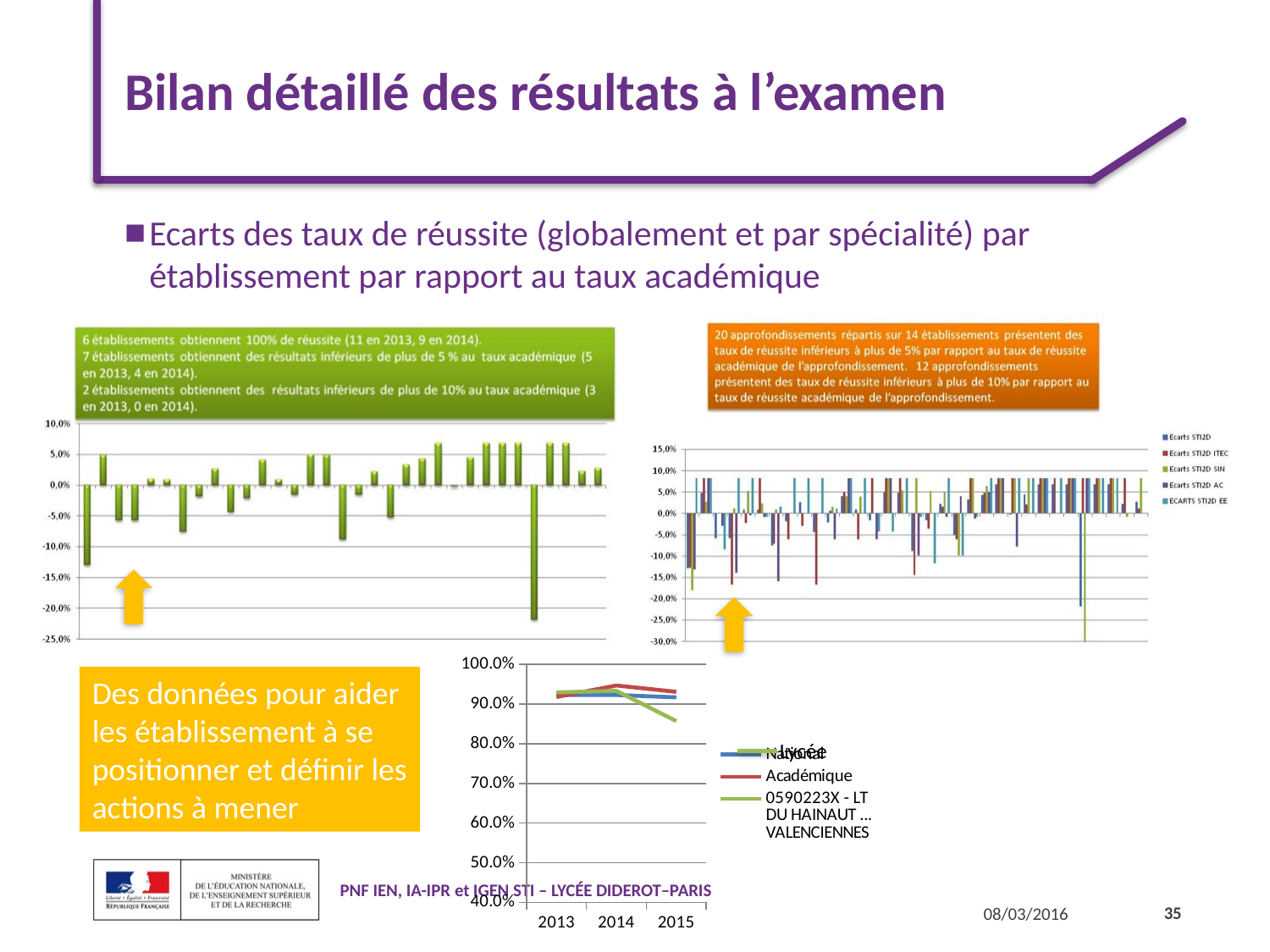
In the bottom line chart, is the Académique value in 2014 greater or less than 90.0%? greater In the bottom line chart, how many series does the legend list? 3 In the bottom line chart, which series has the highest value in 2014? Académique What kind of chart is the chart at the bottom of the slide with years 2013, 2014 and 2015 on the x axis? line chart In the bottom line chart, how many years are shown on the x axis? 3 What kind of chart is the chart at the top right of the slide? bar chart In the bottom line chart, is the value for 0590223X - LT DU HAINAUT VALENCIENNES in 2015 greater or less than 90.0%? less In the bottom line chart, does the value for 0590223X - LT DU HAINAUT VALENCIENNES rise or fall from 2014 to 2015? fall In the bottom line chart, which series has the lowest value in 2015? 0590223X - LT DU HAINAUT VALENCIENNES In the top-left green bar chart, is the lowest bar greater or less than -20,0%? less In the top-right chart, what is the lowest value shown on the y axis? -30,0% In the top-right chart, how many series does the legend list? 5